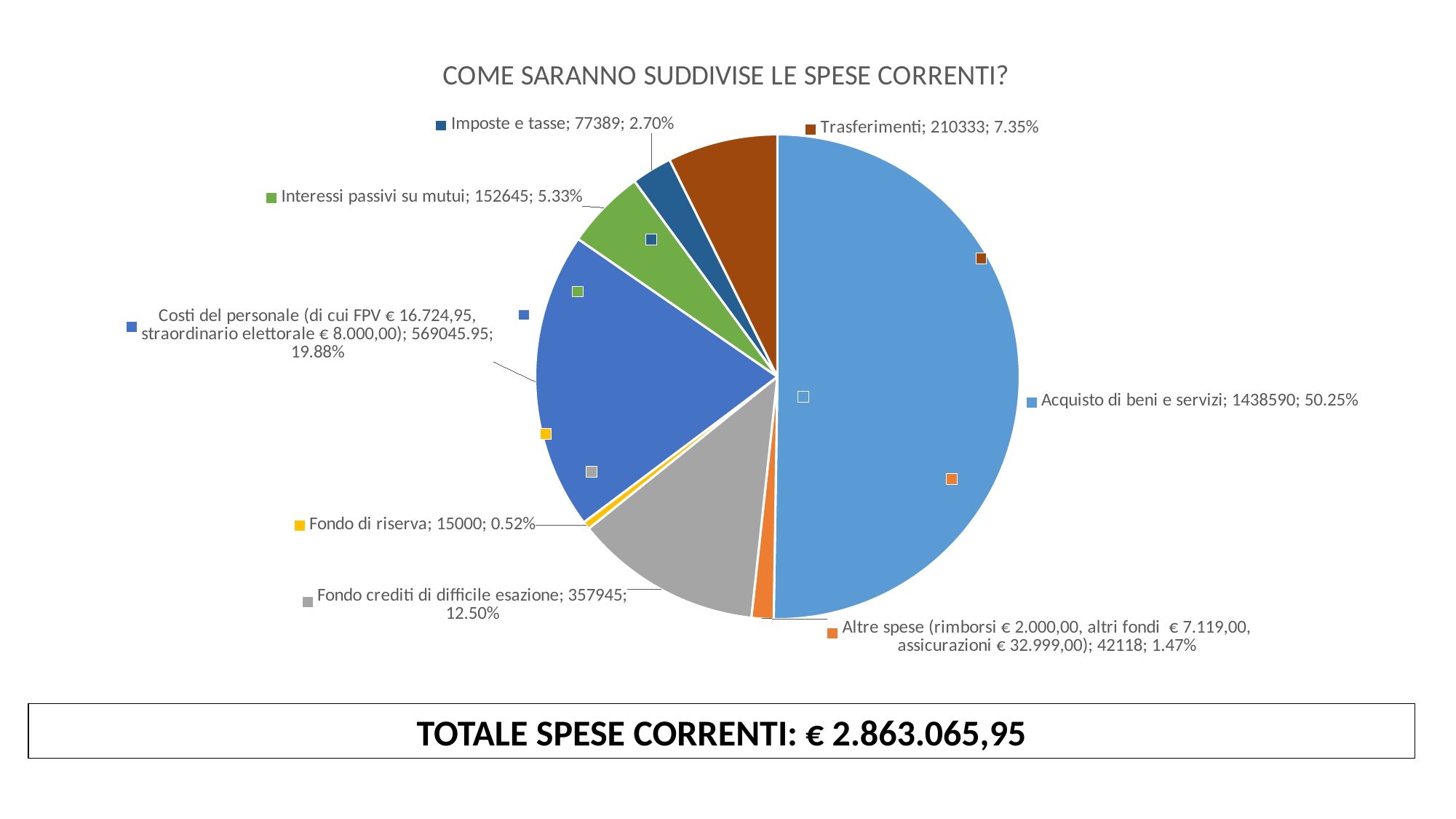
What percentage share does Interessi passivi su mutui have? 5.33% Which category has the smallest slice of the pie? Fondo di riserva How many slices does the pie chart have? 8 What is the value shown for Trasferimenti? 210333 What is the difference between the values for Trasferimenti and Imposte e tasse? 132944 Which category has the largest slice of the pie? Acquisto di beni e servizi What is the title of the chart? COME SARANNO SUDDIVISE LE SPESE CORRENTI? What percentage share does Acquisto di beni e servizi have? 50.25% Which is larger, the value for Fondo crediti di difficile esazione or the value for Interessi passivi su mutui? Fondo crediti di difficile esazione What total is stated in the box below the chart? € 2.863.065,95 What is the value shown for Fondo crediti di difficile esazione? 357945 What kind of chart is shown on the slide? pie chart